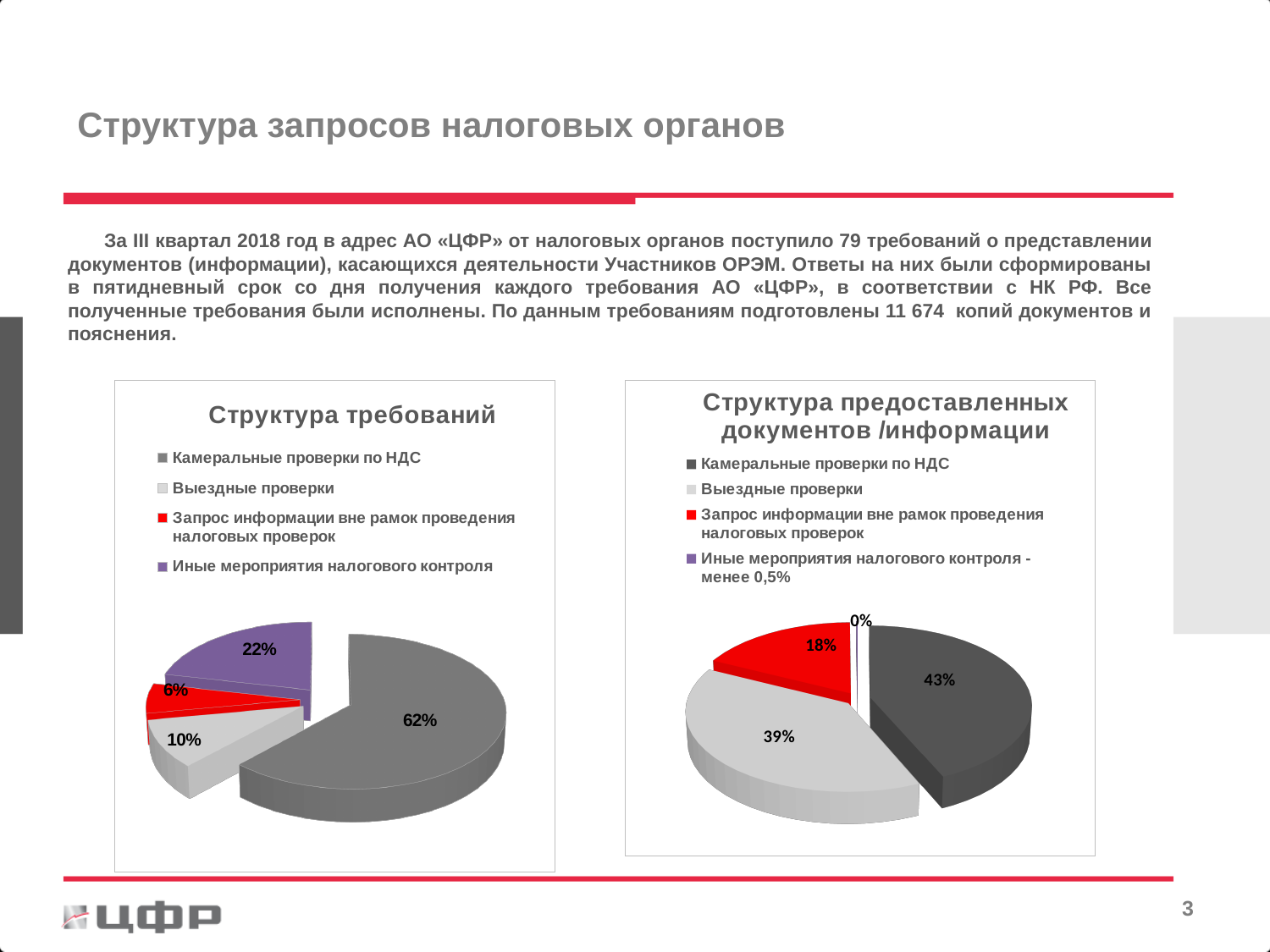
In the chart titled «Структура требований», what share is shown for «Иные мероприятия налогового контроля»? 22% In the chart titled «Структура предоставленных документов /информации», what is the difference between the shares of «Камеральные проверки по НДС» and «Выездные проверки»? 4% How many categories does the legend of the chart titled «Структура требований» list? 4 In the chart titled «Структура предоставленных документов /информации», which is larger: the share of «Выездные проверки» or the share of «Запрос информации вне рамок проведения налоговых проверок»? Выездные проверки In the chart titled «Структура требований», what share is shown for «Камеральные проверки по НДС»? 62% In the chart titled «Структура предоставленных документов /информации», which category has the largest slice? Камеральные проверки по НДС In the chart titled «Структура требований», which category has the smallest slice? Запрос информации вне рамок проведения налоговых проверок In the chart titled «Структура требований», what share is shown for «Выездные проверки»? 10% What type of chart is the chart titled «Структура предоставленных документов /информации»? Pie chart In the chart titled «Структура требований», what is the difference between the shares of «Камеральные проверки по НДС» and «Иные мероприятия налогового контроля»? 40%